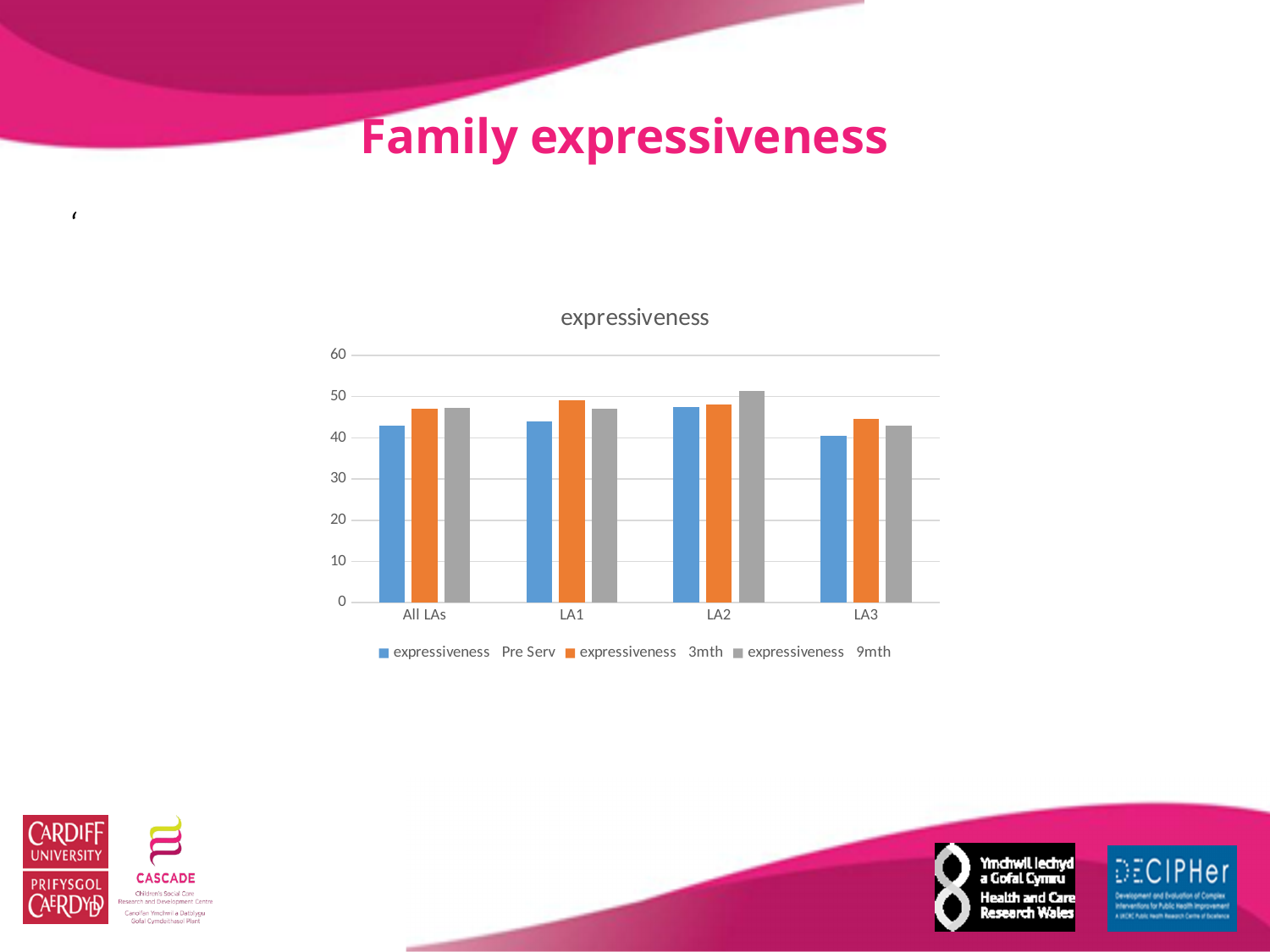
Which category has the lowest value for the expressiveness Pre Serv series? LA3 Is the expressiveness Pre Serv value for LA3 greater or less than 50? less Which category has the lowest value for the expressiveness 9mth series? LA3 Is the expressiveness Pre Serv value for LA1 greater or less than 50? less For LA3, which is larger: the expressiveness Pre Serv value or the expressiveness 3mth value? expressiveness 3mth For LA1, which is larger: the expressiveness Pre Serv value or the expressiveness 3mth value? expressiveness 3mth What is the title of the chart? expressiveness How many categories are shown on the x axis of the chart? 4 Which category has the highest value for the expressiveness 9mth series? LA2 How many series does the chart's legend list? 3 What kind of chart is shown on the slide? bar chart Is the expressiveness 3mth value for All LAs greater or less than 40? greater